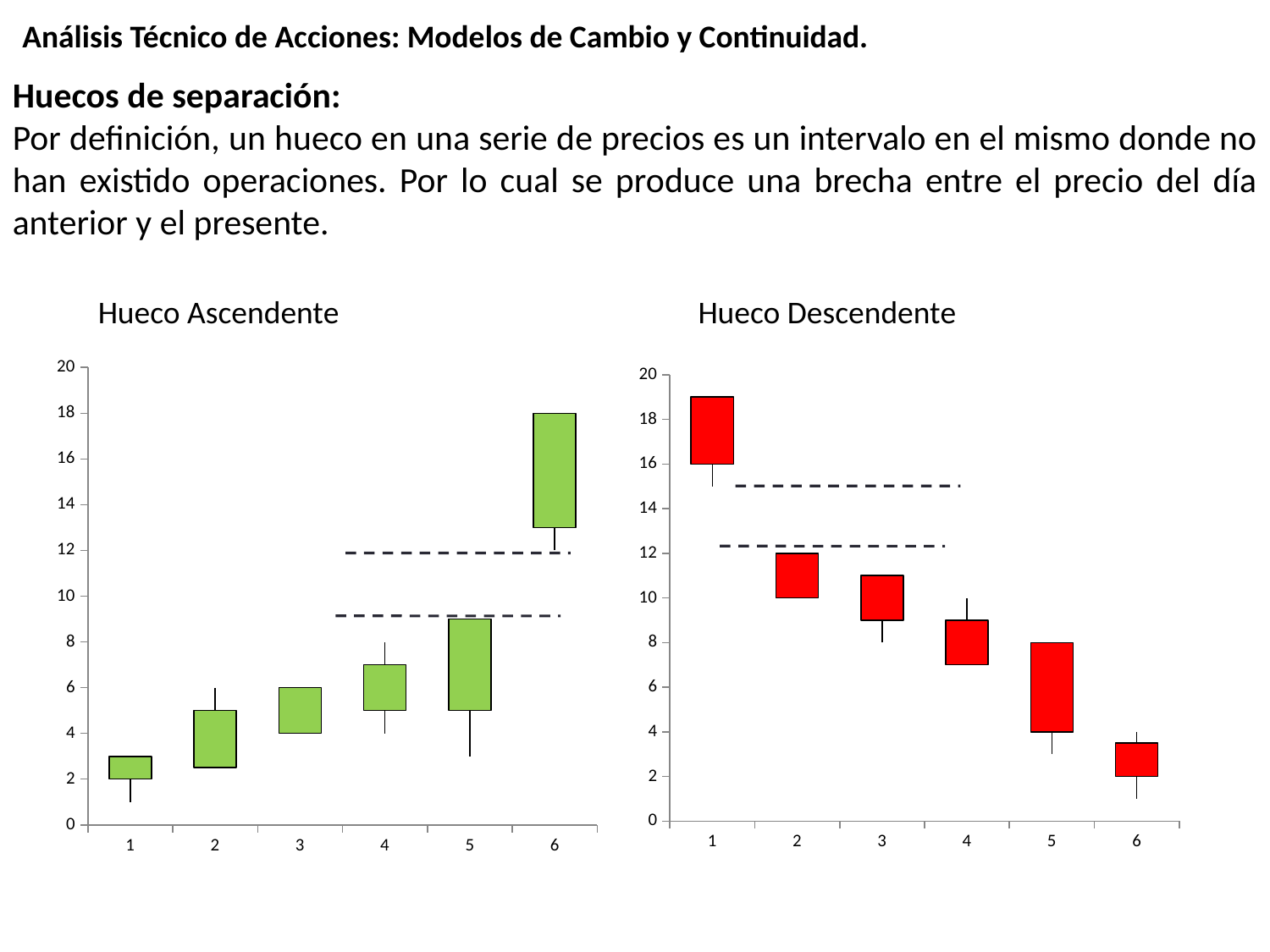
On the "Hueco Ascendente" chart, do the prices rise or fall from period 1 to period 6? rise On the "Hueco Descendente" chart, which period has the lowest candle? 6 On the "Hueco Ascendente" chart, which period has the highest candle? 6 On the "Hueco Descendente" chart, do the prices rise or fall from period 1 to period 6? fall On the "Hueco Descendente" chart, is the bottom of the candle for period 1 greater or less than 14? greater How many candles (periods) are plotted on the "Hueco Descendente" chart? 6 What kind of chart is the "Hueco Ascendente" chart? candlestick chart What colour are the candles on the "Hueco Descendente" chart? red On the "Hueco Ascendente" chart, is the top of the candle for period 1 greater or less than 4? less How many candles (periods) are plotted on the "Hueco Ascendente" chart? 6 On the "Hueco Ascendente" chart, is the top of the candle for period 6 greater or less than 16? greater